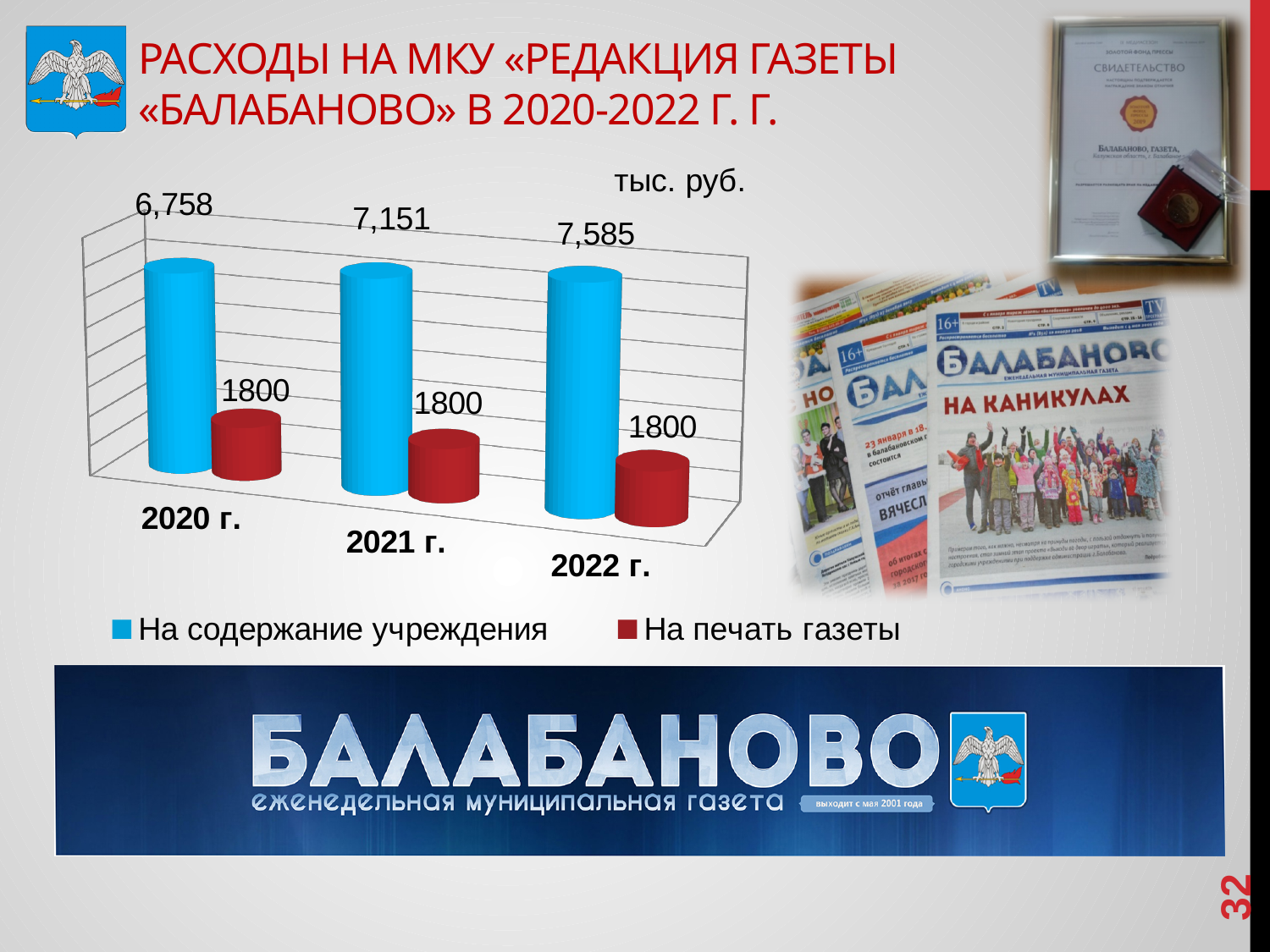
Do the values for «На содержание учреждения» rise or fall from 2020 г. to 2022 г.? Rise How many years (categories) are shown on the chart? 3 What is the value for «На содержание учреждения» in 2022 г.? 7,585 In which year is the value for «На содержание учреждения» highest? 2022 г. Which is larger in 2021 г.: «На содержание учреждения» or «На печать газеты»? На содержание учреждения What unit is indicated for the chart values? тыс. руб. In which year is the value for «На содержание учреждения» lowest? 2020 г. What is the value for «На содержание учреждения» in 2020 г.? 6,758 What kind of chart is shown on the slide? Bar chart How many series does the legend list? 2 What is the difference between the «На содержание учреждения» values for 2022 г. and 2020 г.? 827 What is the value for «На печать газеты» in 2021 г.? 1800